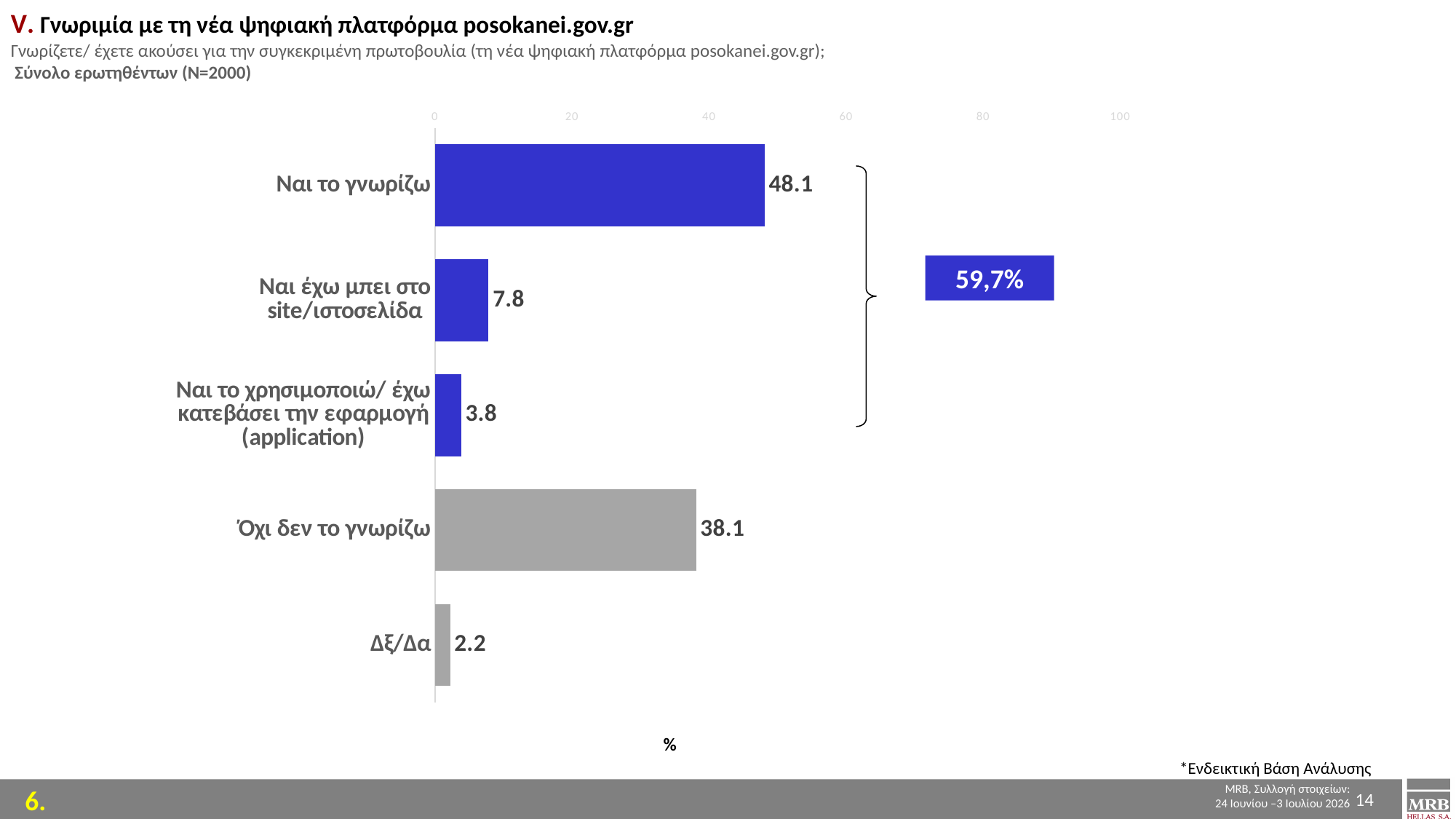
Which category has the lowest value? Δξ/Δα How many categories are shown in the chart? 5 Is the value for "Ναι το γνωρίζω" greater or less than 40? greater Which category has the highest value? Ναι το γνωρίζω Which is larger, the value for "Ναι έχω μπει στο site/ιστοσελίδα" or the value for "Ναι το χρησιμοποιώ/ έχω κατεβάσει την εφαρμογή (application)"? Ναι έχω μπει στο site/ιστοσελίδα What is the value for "Ναι έχω μπει στο site/ιστοσελίδα"? 7.8 What kind of chart is shown on the slide? bar chart What is the value for "Ναι το γνωρίζω"? 48.1 What is the value for "Όχι δεν το γνωρίζω"? 38.1 What percentage is shown next to the bracket grouping the three "Ναι" bars? 59,7% What is the difference between the values for "Ναι το γνωρίζω" and "Όχι δεν το γνωρίζω"? 10 What is the value for "Δξ/Δα"? 2.2